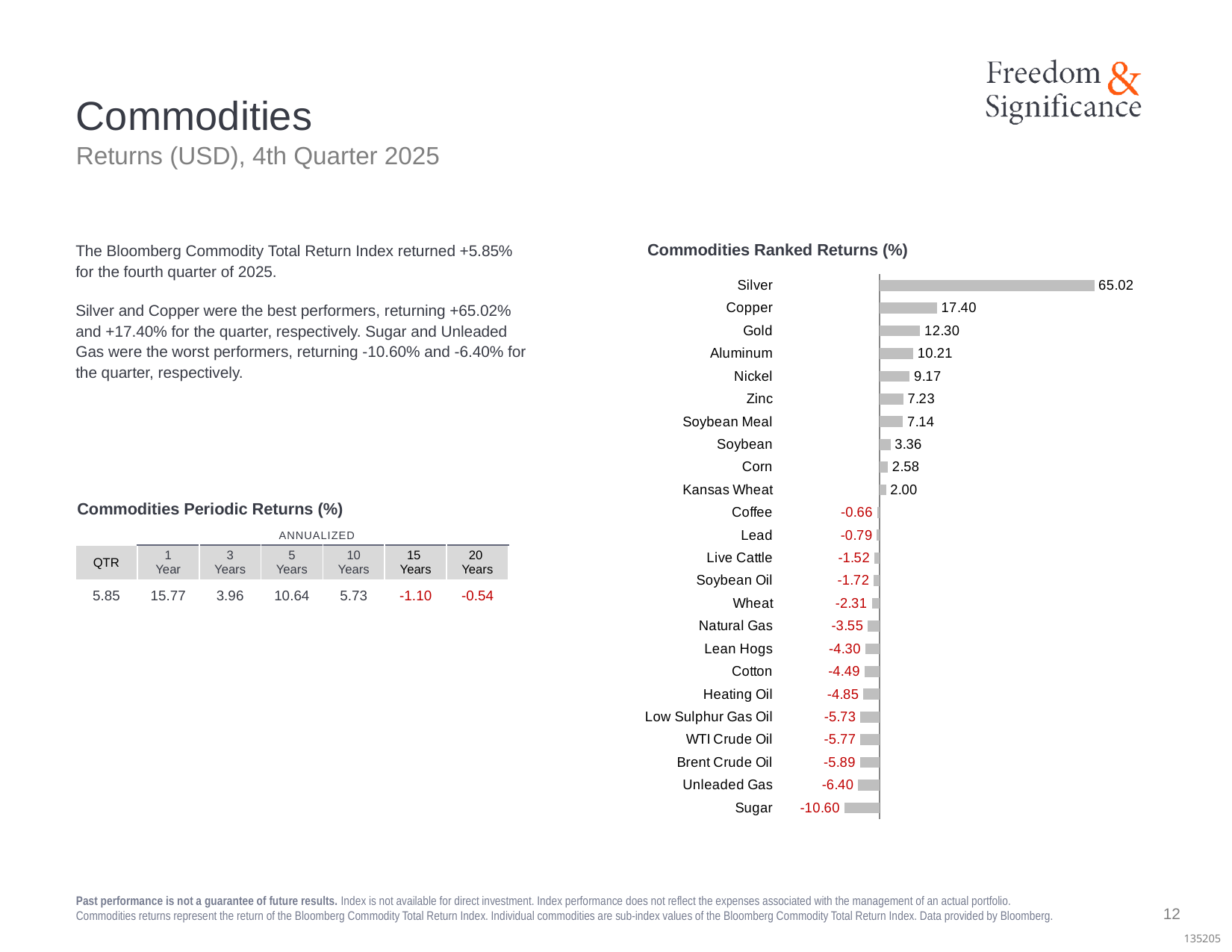
In the Commodities Ranked Returns (%) chart, what is the value for Gold? 12.30 How many commodities are shown in the Commodities Ranked Returns (%) chart? 24 In the Commodities Ranked Returns (%) chart, which commodity has the highest return? Silver In the Commodities Ranked Returns (%) chart, what is the difference between the values for Silver and Copper? 47.62 In the Commodities Ranked Returns (%) chart, which has the larger value, Coffee or Cotton? Coffee In the Commodities Ranked Returns (%) chart, which commodity has the lowest return? Sugar In the Commodities Ranked Returns (%) chart, which has the larger value, Aluminum or Soybean Meal? Aluminum What is the title of the chart on the slide? Commodities Ranked Returns (%) In the Commodities Ranked Returns (%) chart, what is the value for Natural Gas? -3.55 In the Commodities Ranked Returns (%) chart, what is the value for Kansas Wheat? 2.00 What kind of chart is the Commodities Ranked Returns (%) chart? Bar chart In the Commodities Ranked Returns (%) chart, what is the difference between the values for Nickel and Zinc? 1.94